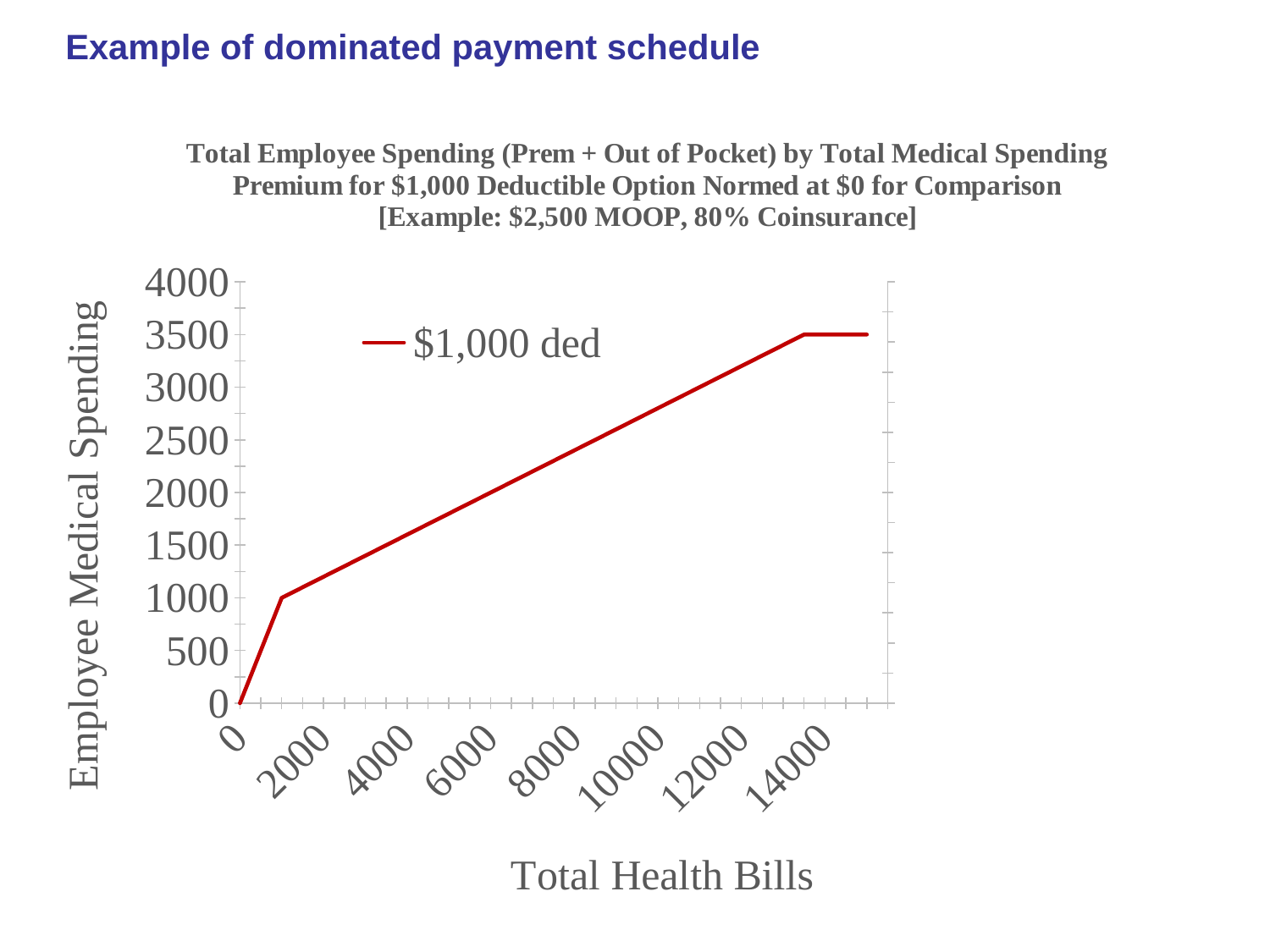
What is the value of the $1,000 ded line when Total Health Bills is 0? 0 Is the value of the $1,000 ded line at Total Health Bills of 2000 greater or less than 1500? less What is the title of the x axis? Total Health Bills What kind of chart is shown on the slide? line chart How many series does the legend list? 1 Is the value of the $1,000 ded line at Total Health Bills of 6000 greater or less than 2500? less Is the value of the $1,000 ded line at Total Health Bills of 12000 greater or less than 3000? greater What is the highest value the $1,000 ded line reaches on the y axis? 3500 Does the line generally rise or fall as Total Health Bills increase? rise What is the name of the series shown in the legend? $1,000 ded